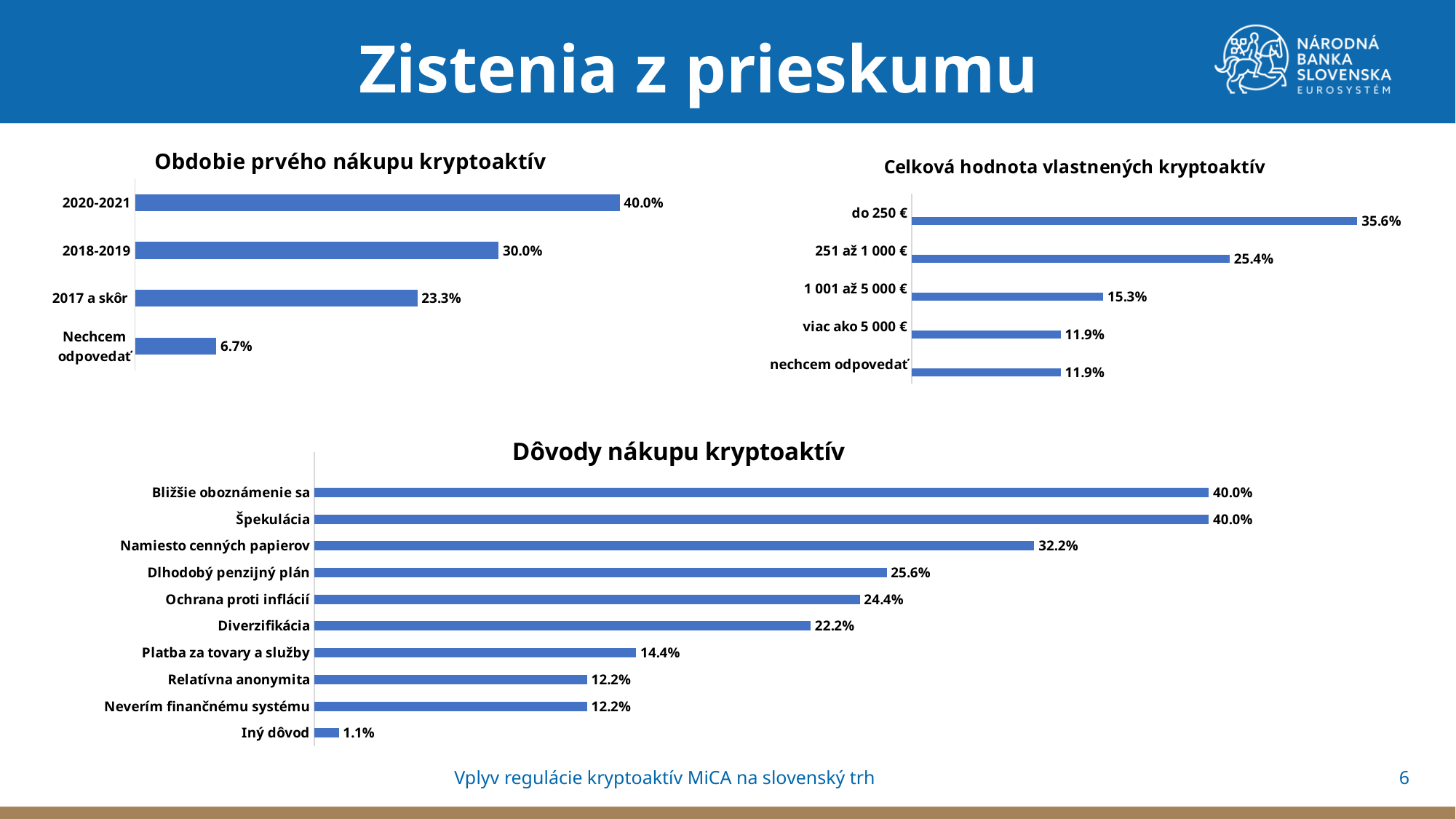
In the chart 'Celková hodnota vlastnených kryptoaktív', what is the value for 1 001 až 5 000 €? 15.3% In the chart 'Celková hodnota vlastnených kryptoaktív', what is the difference between the values for do 250 € and 251 až 1 000 €? 10.2% In the chart 'Dôvody nákupu kryptoaktív', which category has the lowest value? Iný dôvod What type of chart is 'Dôvody nákupu kryptoaktív'? Bar chart In the chart 'Obdobie prvého nákupu kryptoaktív', what is the difference between the values for 2020-2021 and 2017 a skôr? 16.7% In the chart 'Celková hodnota vlastnených kryptoaktív', which category has the highest value? do 250 € In the chart 'Dôvody nákupu kryptoaktív', which is larger: Diverzifikácia or Platba za tovary a služby? Diverzifikácia In the chart 'Obdobie prvého nákupu kryptoaktív', how many categories are shown? 4 In the chart 'Obdobie prvého nákupu kryptoaktív', which category has the highest value? 2020-2021 In the chart 'Dôvody nákupu kryptoaktív', how many categories are shown? 10 In the chart 'Obdobie prvého nákupu kryptoaktív', what is the value for 2018-2019? 30.0% In the chart 'Dôvody nákupu kryptoaktív', what is the value for Ochrana proti inflácií? 24.4%